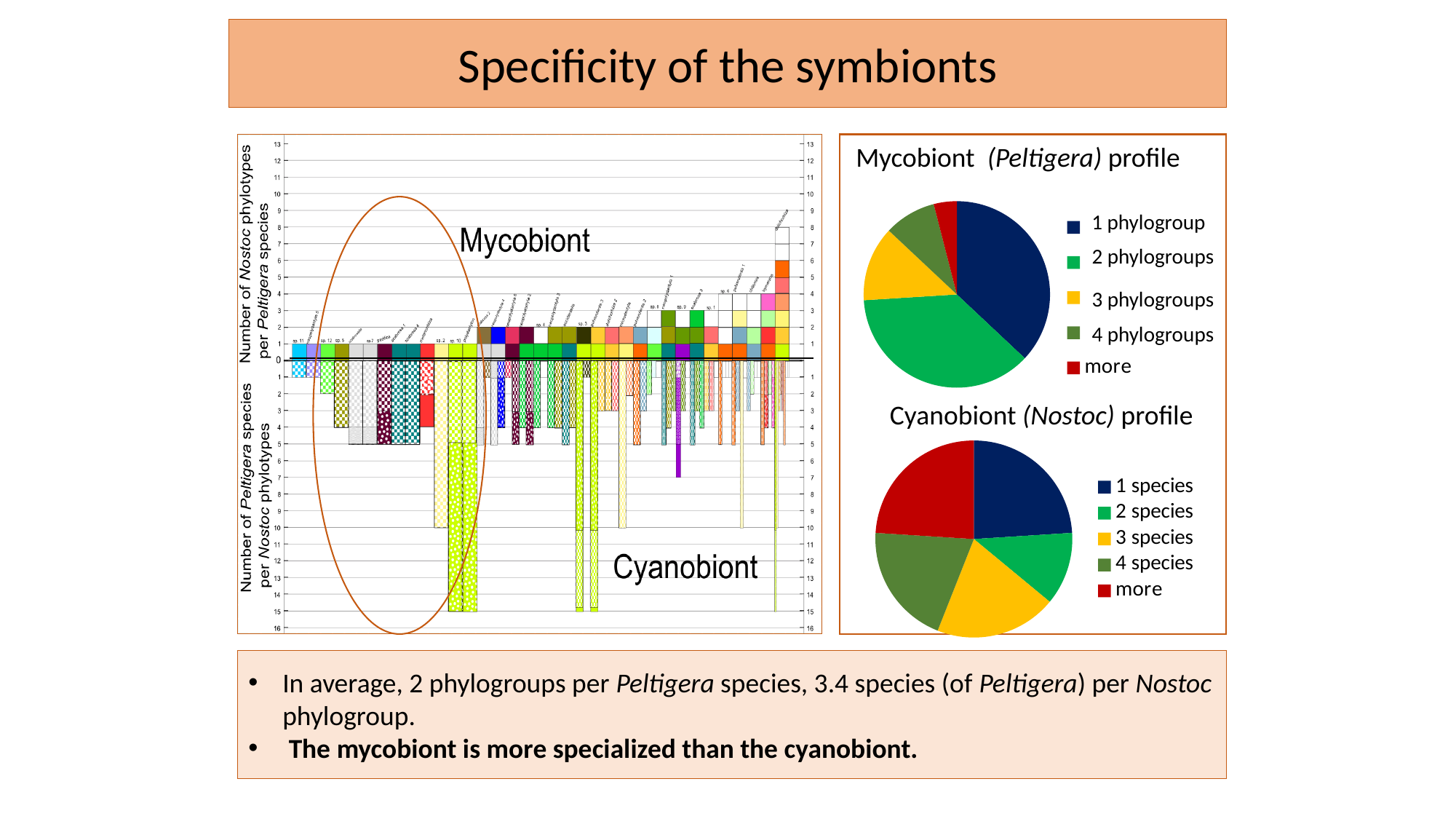
In the 'Mycobiont (Peltigera) profile' pie chart, which category has the smallest slice? more What kind of chart is the 'Cyanobiont (Nostoc) profile' chart? pie chart In the 'Mycobiont (Peltigera) profile' pie chart, which slice is larger: '3 phylogroups' or '4 phylogroups'? 3 phylogroups What kind of chart is the 'Mycobiont (Peltigera) profile' chart? pie chart How many categories does the legend of the 'Cyanobiont (Nostoc) profile' pie chart list? 5 In the large bar chart on the left, what is the highest tick value shown on the lower (Cyanobiont) vertical axis? 16 What kind of chart is the large chart on the left labelled Mycobiont and Cyanobiont? bar chart In the 'Cyanobiont (Nostoc) profile' pie chart, what colour is the 'more' slice? red In the 'Mycobiont (Peltigera) profile' pie chart, what colour is the '1 phylogroup' slice? dark blue In the 'Cyanobiont (Nostoc) profile' pie chart, which slice is larger: '2 species' or '4 species'? 4 species In the 'Cyanobiont (Nostoc) profile' pie chart, which category has the smallest slice? 2 species How many categories does the legend of the 'Mycobiont (Peltigera) profile' pie chart list? 5